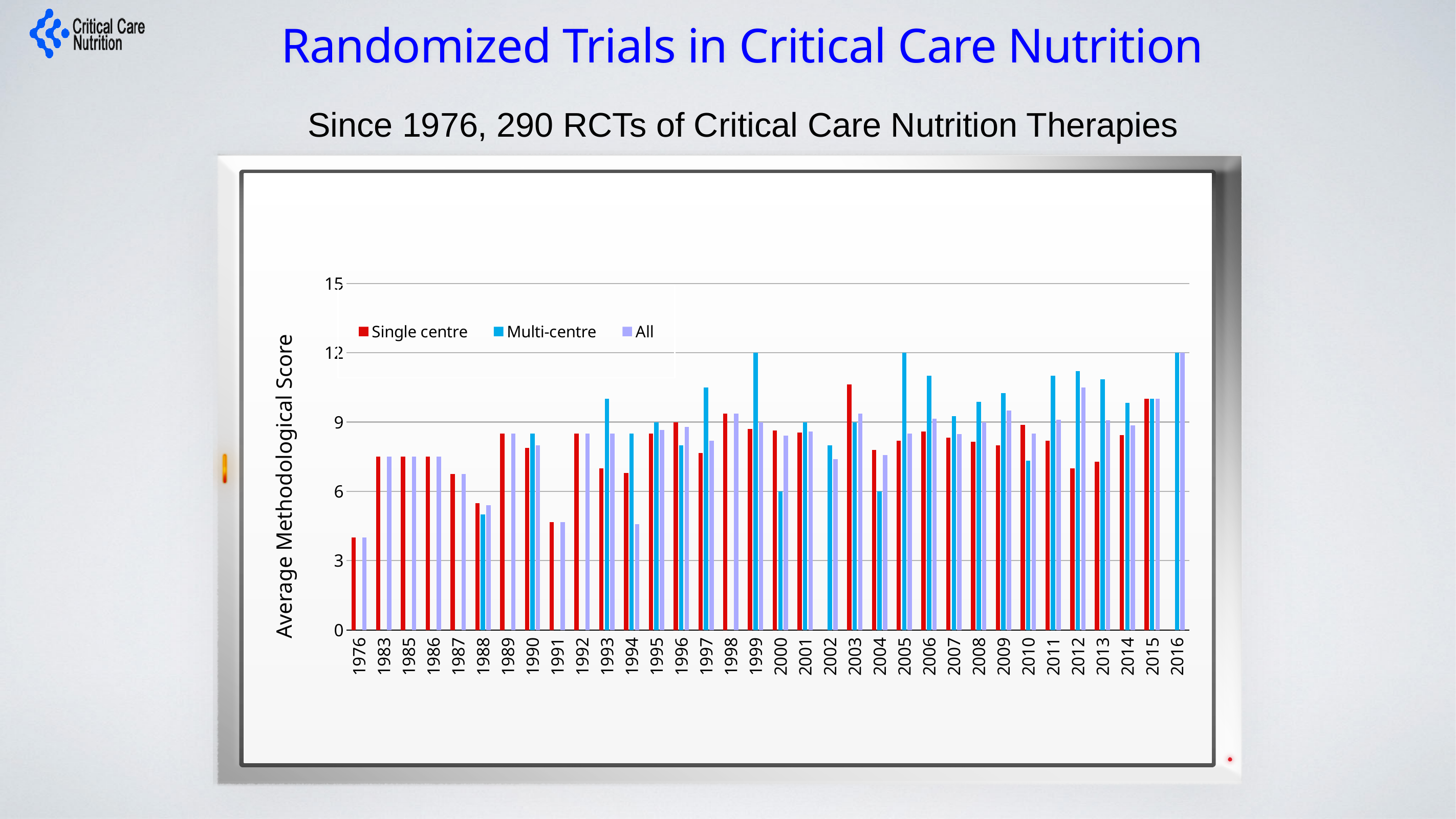
What is the Multi-centre value for 1999? 12 Which year has the highest Single centre value? 2003 What kind of chart is shown on the slide? bar chart Is the Single centre value for 1976 greater or less than 6? less How many series does the chart legend list? 3 What is the label of the vertical axis of the chart? Average Methodological Score What is the Multi-centre value for 2004? 6 What is the Single centre value for 1996? 9 How many years are shown along the x axis of the chart? 34 Is the Single centre value for 2003 greater or less than 9? greater For 1999, which is larger: the Single centre value or the Multi-centre value? Multi-centre Is the Multi-centre value for 2012 greater or less than 9? greater